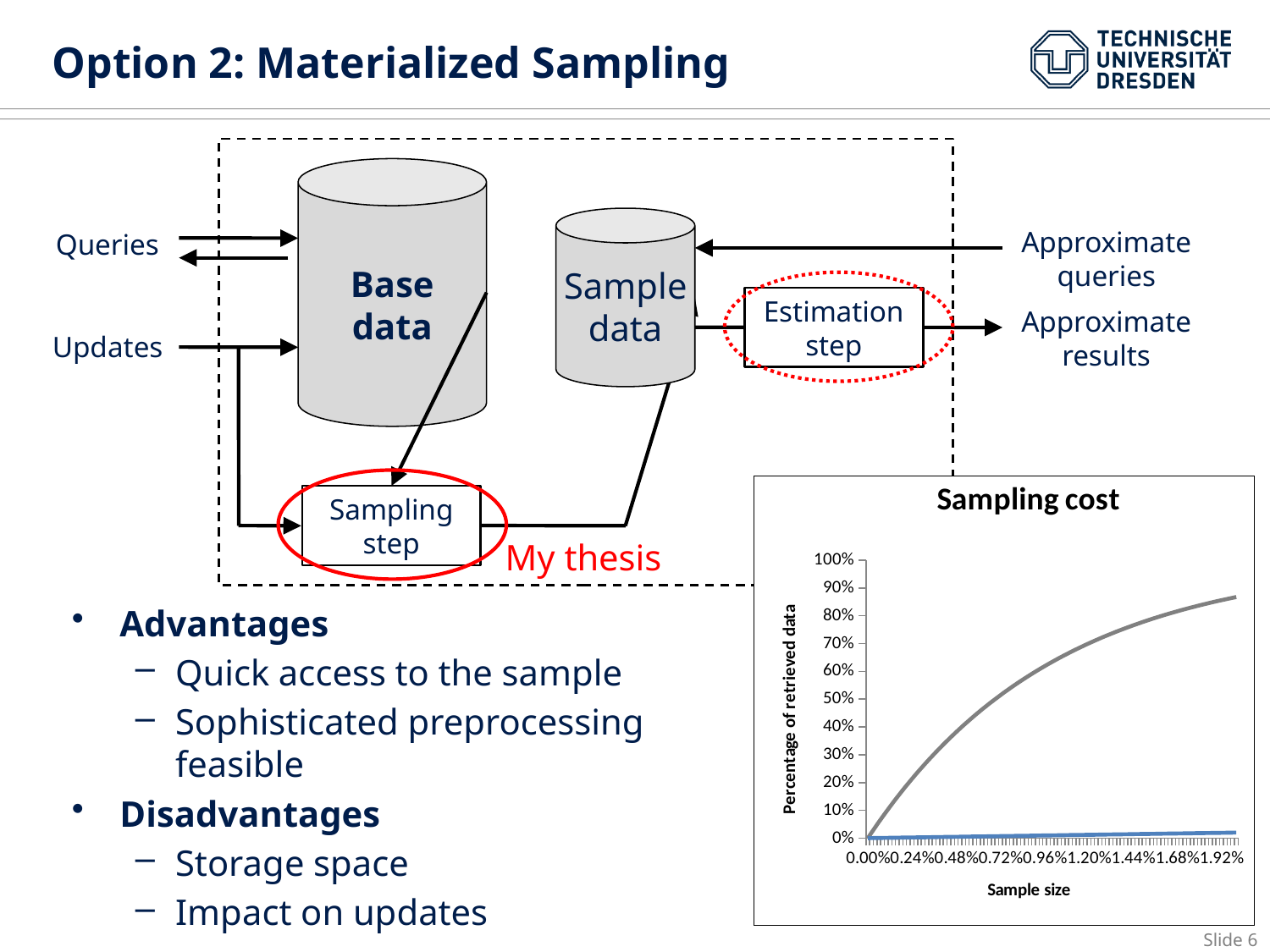
What is the label of the x axis of the 'Sampling cost' chart? Sample size In the 'Sampling cost' chart, is the value of the gray line at a sample size of 0.24% greater or less than 30%? less In the 'Sampling cost' chart, is the value of the blue line at a sample size of 1.92% greater or less than 10%? less What is the largest sample size tick label shown on the x axis of the 'Sampling cost' chart? 1.92% What is the highest tick value shown on the y axis of the 'Sampling cost' chart? 100% In the 'Sampling cost' chart, does the gray line rise or fall as sample size increases? rise In the 'Sampling cost' chart, is the value of the gray line at a sample size of 1.92% greater or less than 80%? greater What is the title of the chart on the slide? Sampling cost In the 'Sampling cost' chart, which line has the higher value at a sample size of 1.92%, the gray line or the blue line? the gray line How many lines are plotted in the 'Sampling cost' chart? 2 What kind of chart is the 'Sampling cost' chart? line chart